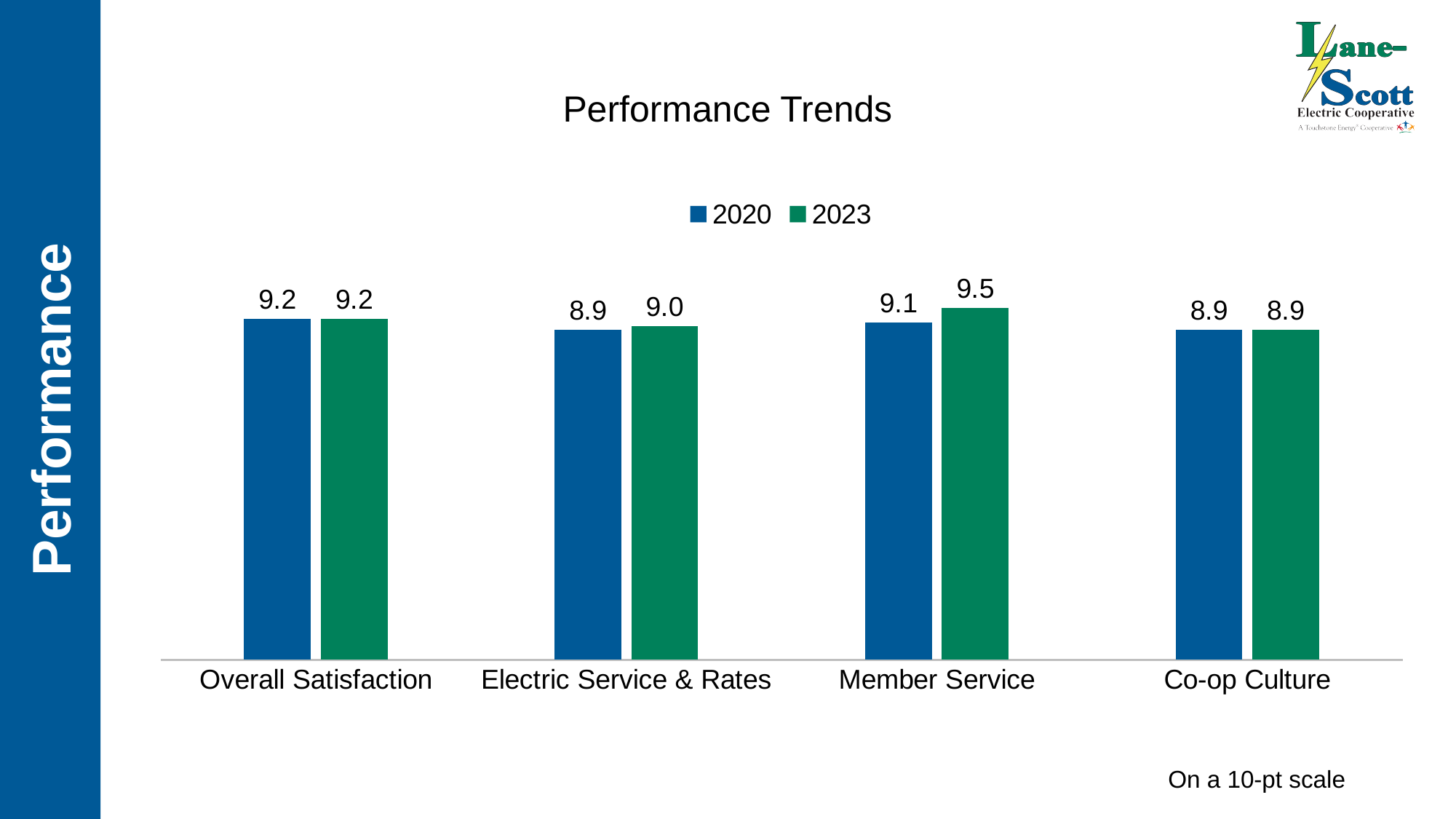
How many categories are shown on the x axis? 4 Which category has the highest 2023 value? Member Service What is the difference between the 2023 and 2020 values for Member Service? 0.4 What kind of chart is shown on the slide? Bar chart Which is larger for Electric Service & Rates, the 2020 value or the 2023 value? 2023 What is the 2023 value for Co-op Culture? 8.9 What is the title of the chart? Performance Trends What is the 2020 value for Overall Satisfaction? 9.2 What is the 2023 value for Member Service? 9.5 How many series does the legend list? 2 Which category has the lowest 2020 value? Electric Service & Rates and Co-op Culture (both 8.9) What is the 2020 value for Electric Service & Rates? 8.9